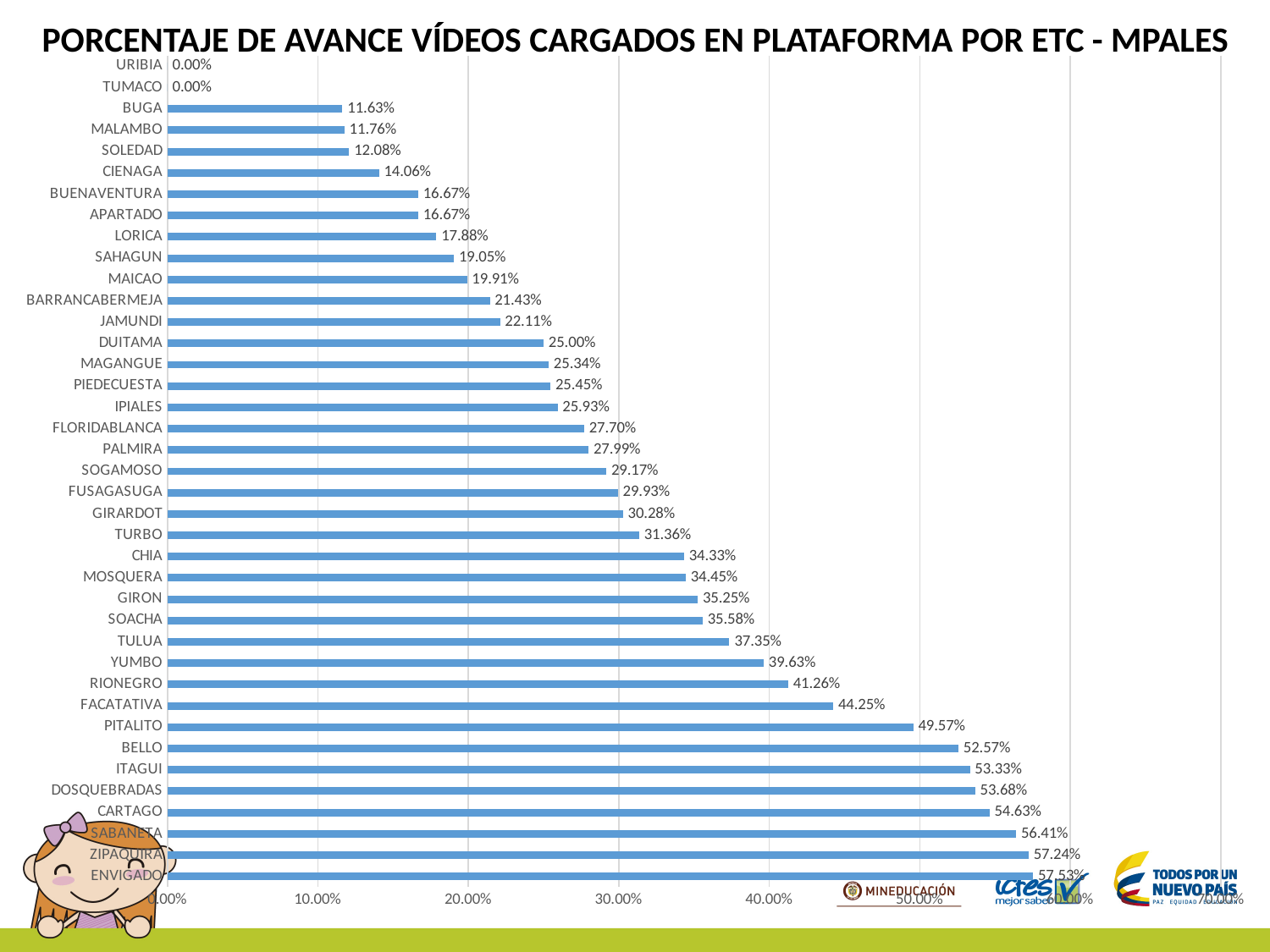
What kind of chart is shown on the slide? Bar chart What is the value for TUMACO? 0.00% What is the value for FACATATIVA? 44.25% What is the title of the chart? PORCENTAJE DE AVANCE VÍDEOS CARGADOS EN PLATAFORMA POR ETC - MPALES What is the difference between the values for BELLO and PITALITO? 3.00% Is the value for CARTAGO greater or less than 50.00%? greater What is the value for PITALITO? 49.57% How many categories are shown in the chart? 39 Which has a larger value, RIONEGRO or TURBO? RIONEGRO What is the difference between the values for YUMBO and TULUA? 2.28% What is the value for CIENAGA? 14.06% What is the value for SABANETA? 56.41%